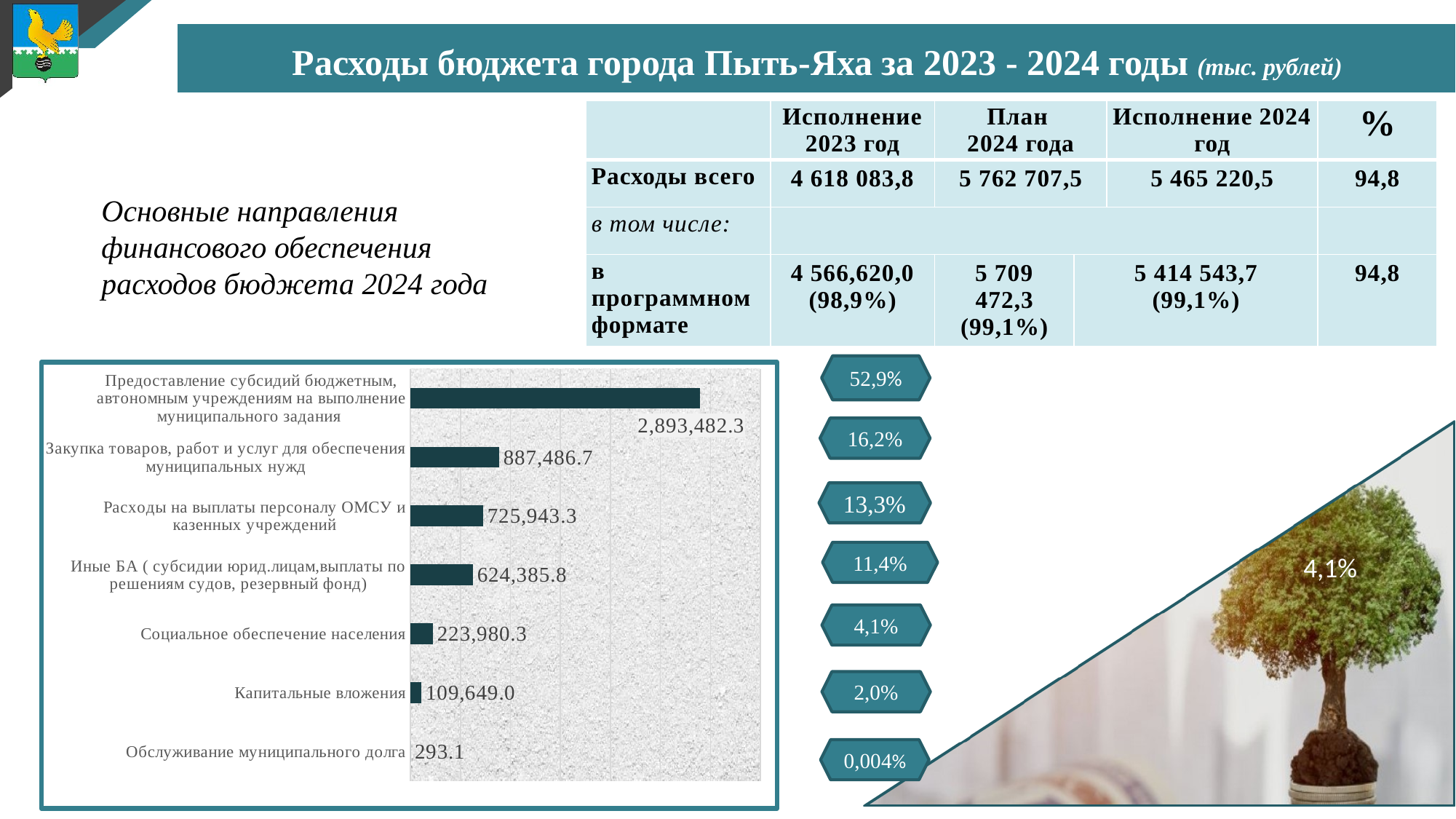
Which category has the highest value in the bar chart? Предоставление субсидий бюджетным, автономным учреждениям на выполнение муниципального задания What is the value for Капитальные вложения? 109,649.0 What is the value for Обслуживание муниципального долга? 293.1 What is the difference between the values for Социальное обеспечение населения and Капитальные вложения? 114,331.3 What is the value for Социальное обеспечение населения? 223,980.3 How many categories are shown in the bar chart? 7 Which is larger: the value for Расходы на выплаты персоналу ОМСУ и казенных учреждений or the value for Иные БА (субсидии юрид.лицам, выплаты по решениям судов, резервный фонд)? Расходы на выплаты персоналу ОМСУ и казенных учреждений What is the value for Закупка товаров, работ и услуг для обеспечения муниципальных нужд? 887,486.7 What is the value for Расходы на выплаты персоналу ОМСУ и казенных учреждений? 725,943.3 What kind of chart is shown on the slide? Bar chart What is the difference between the values for Закупка товаров, работ и услуг для обеспечения муниципальных нужд and Расходы на выплаты персоналу ОМСУ и казенных учреждений? 161,543.4 Which category has the lowest value in the bar chart? Обслуживание муниципального долга